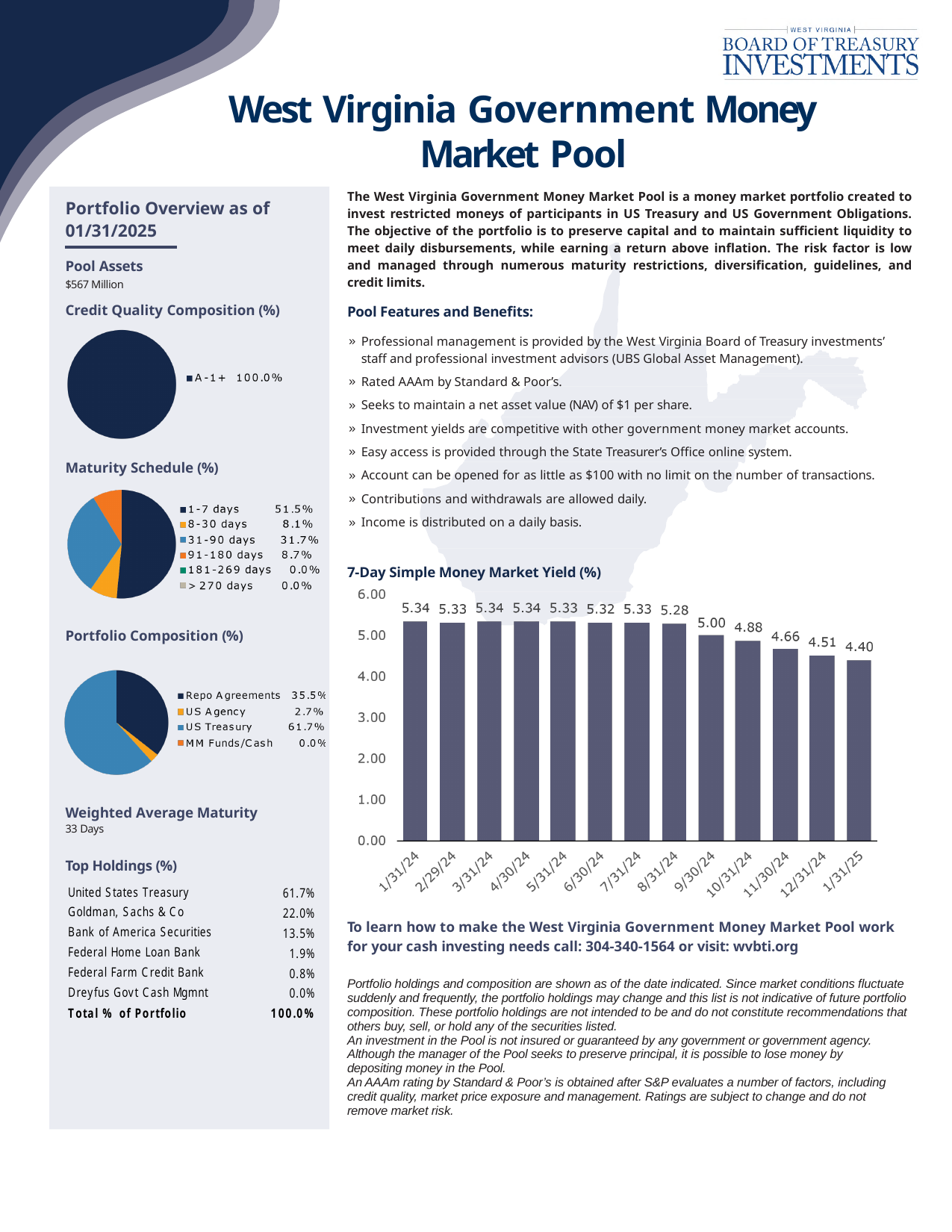
In the Maturity Schedule (%) pie chart, what share is 31-90 days? 31.7% In the 7-Day Simple Money Market Yield (%) chart, what is the value for 9/30/24? 5.00 In the 7-Day Simple Money Market Yield (%) chart, which date has the lowest yield? 1/31/25 In the 7-Day Simple Money Market Yield (%) chart, do the values generally rise or fall from 1/31/24 to 1/31/25? fall In the Portfolio Composition (%) pie chart, what share is Repo Agreements? 35.5% What kind of chart is the 7-Day Simple Money Market Yield (%) chart? bar chart In the Maturity Schedule (%) pie chart, which category has the largest share? 1-7 days In the 7-Day Simple Money Market Yield (%) chart, what is the difference between the values for 1/31/24 and 1/31/25? 0.94 How many bars are plotted in the 7-Day Simple Money Market Yield (%) chart? 13 How many entries does the legend of the Portfolio Composition (%) pie chart list? 4 In the 7-Day Simple Money Market Yield (%) chart, what is the value for 1/31/25? 4.40 In the 7-Day Simple Money Market Yield (%) chart, which is larger, the value for 8/31/24 or the value for 10/31/24? 8/31/24